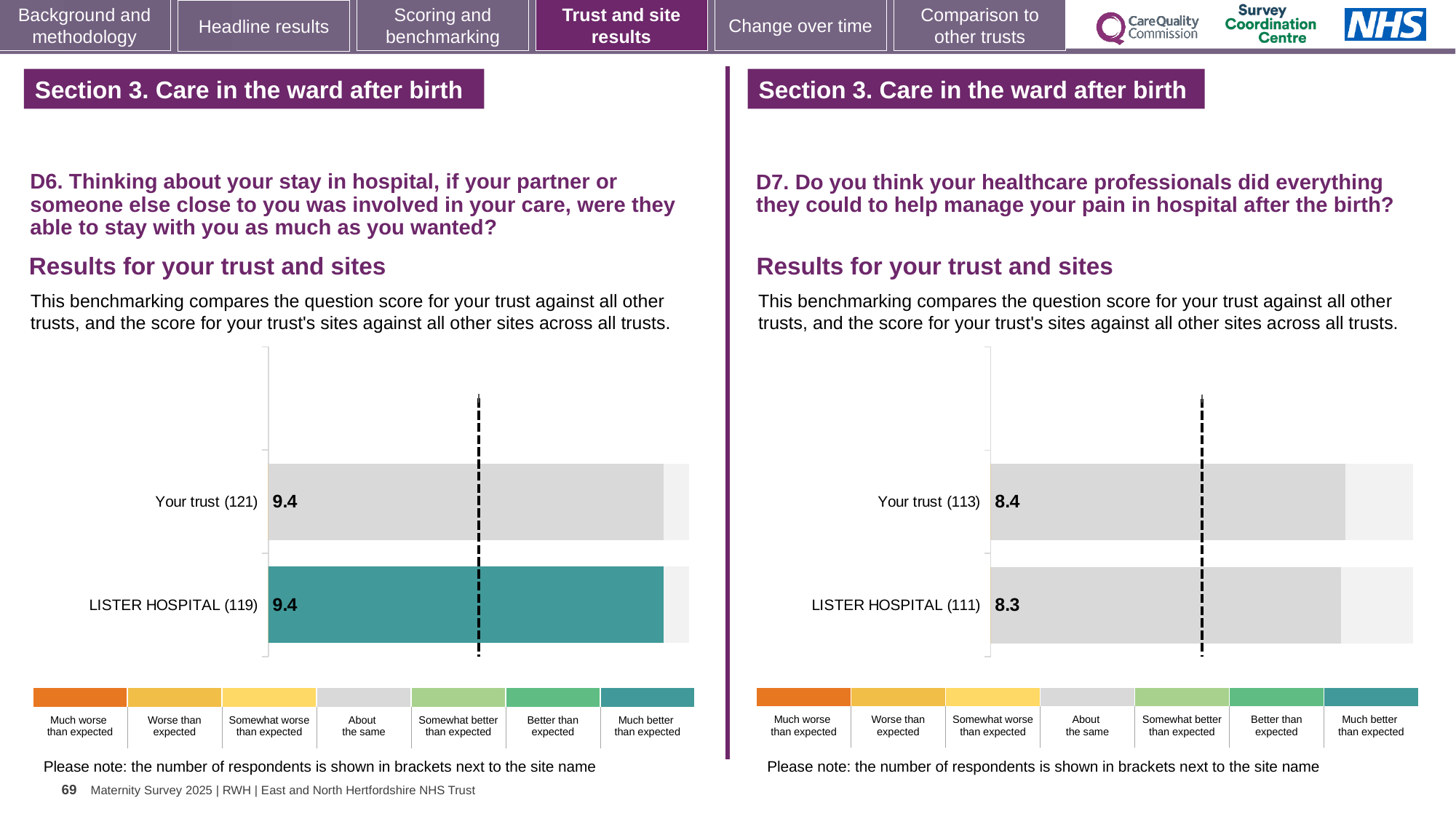
In the D6 chart on the left, what is the score for LISTER HOSPITAL? 9.4 In the D6 chart on the left, what is the score for Your trust? 9.4 In the D7 chart on the right, which has the higher score, Your trust or LISTER HOSPITAL? Your trust In the D7 chart on the right, what is the difference between the score for Your trust and the score for LISTER HOSPITAL? 0.1 In the D6 chart on the left, what is the difference between the score for Your trust and the score for LISTER HOSPITAL? 0 What type of chart is used in the D6 chart on the left? Bar chart In the D6 chart on the left, how many respondents are shown in brackets for LISTER HOSPITAL? 119 How many bars are plotted in the D6 chart on the left? 2 In the D7 chart on the right, what is the score for Your trust? 8.4 In the D7 chart on the right, what is the score for LISTER HOSPITAL? 8.3 In the D6 chart on the left, which benchmarking category does the colour of the LISTER HOSPITAL bar correspond to? Much better than expected How many bars are plotted in the D7 chart on the right? 2